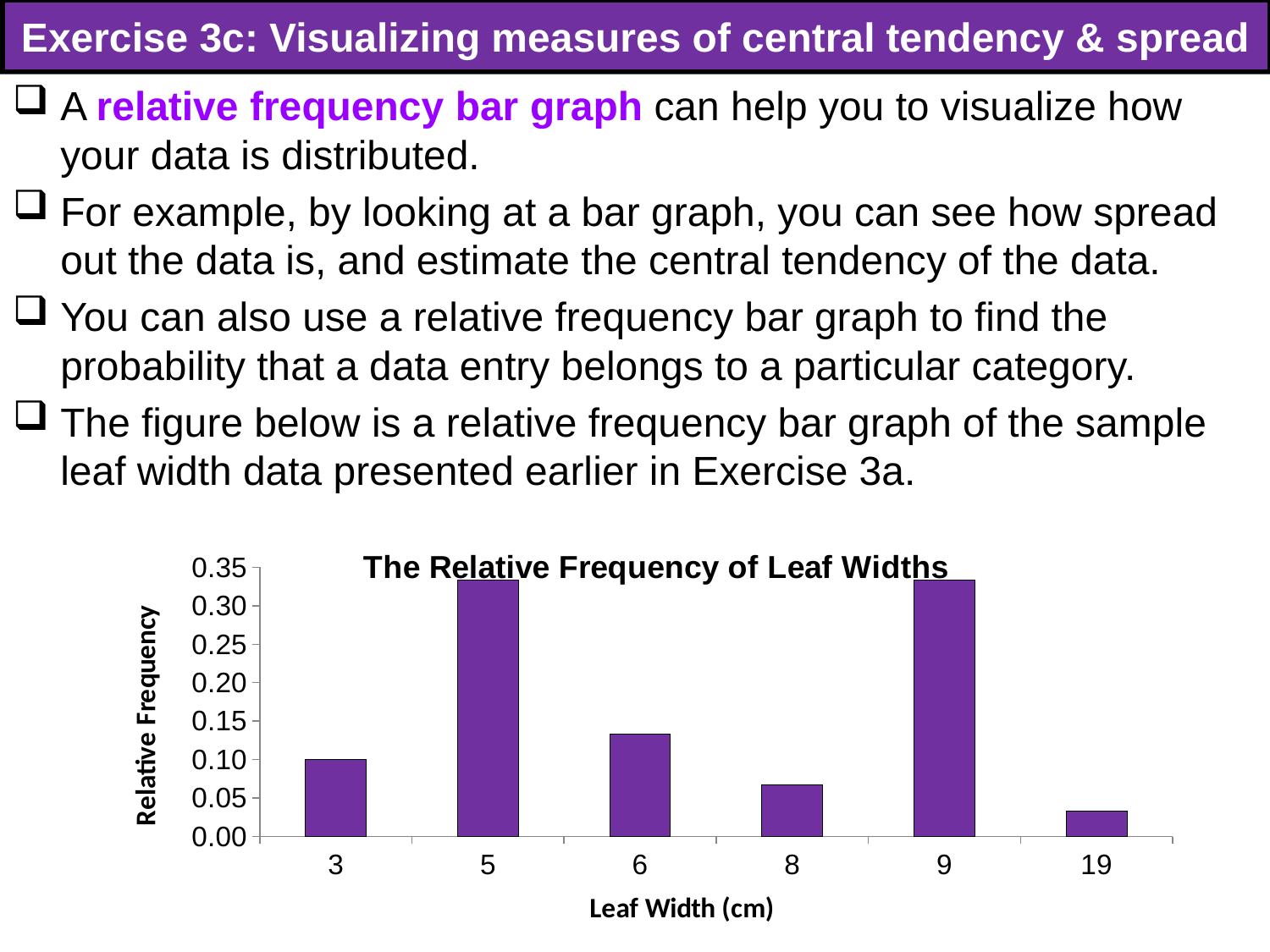
Is the relative frequency for a leaf width of 8 cm greater or less than 0.05? greater Is the relative frequency for a leaf width of 6 cm greater or less than 0.10? greater Which has a higher relative frequency, a leaf width of 6 cm or 8 cm? 6 What is the relative frequency for a leaf width of 3 cm? 0.10 Is the relative frequency for a leaf width of 19 cm greater or less than 0.05? less What is the label on the x axis of the chart? Leaf Width (cm) What is the title of the chart? The Relative Frequency of Leaf Widths Which has a higher relative frequency, a leaf width of 9 cm or 3 cm? 9 Which leaf width has the lowest relative frequency? 19 What kind of chart is shown on the slide? bar chart How many leaf width categories are shown on the x axis of the chart? 6